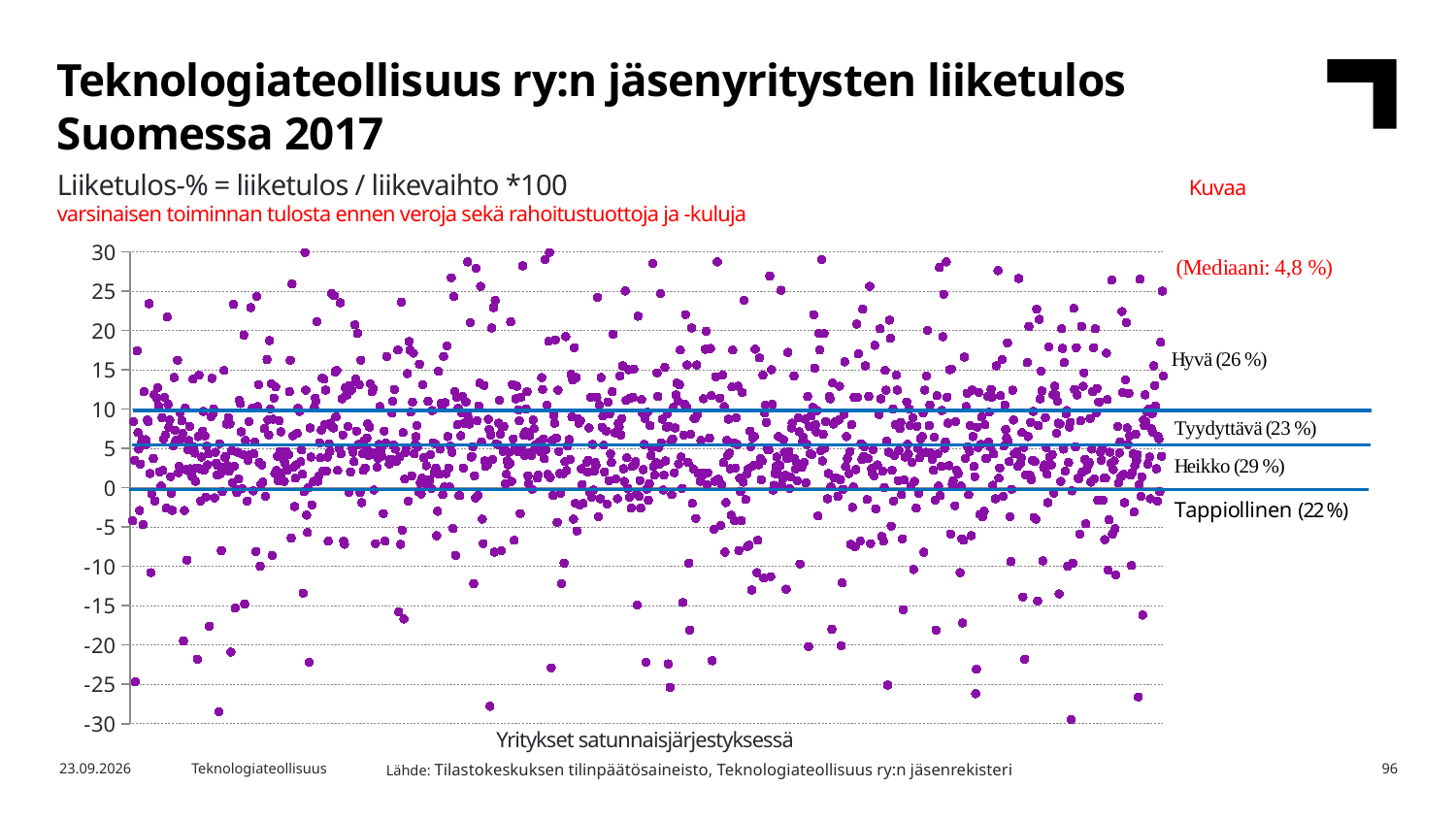
What is the difference in percentage points between the Hyvä share and the Tappiollinen share? 4 percentage points What share of companies falls into the Tyydyttävä category? 23 % What share of companies falls into the Hyvä category? 26 % What is the label under the horizontal axis of the chart? Yritykset satunnaisjärjestyksessä What kind of chart is shown on the slide? Scatter chart Which category has a larger share of companies, Hyvä or Tyydyttävä? Hyvä Which category has the smallest share of companies? Tappiollinen What share of companies falls into the Tappiollinen category? 22 % What share of companies falls into the Heikko category? 29 % What is the median operating profit percentage (mediaani) shown on the chart? 4,8 % What is the highest value shown on the vertical axis of the chart? 30 Which category has the largest share of companies? Heikko